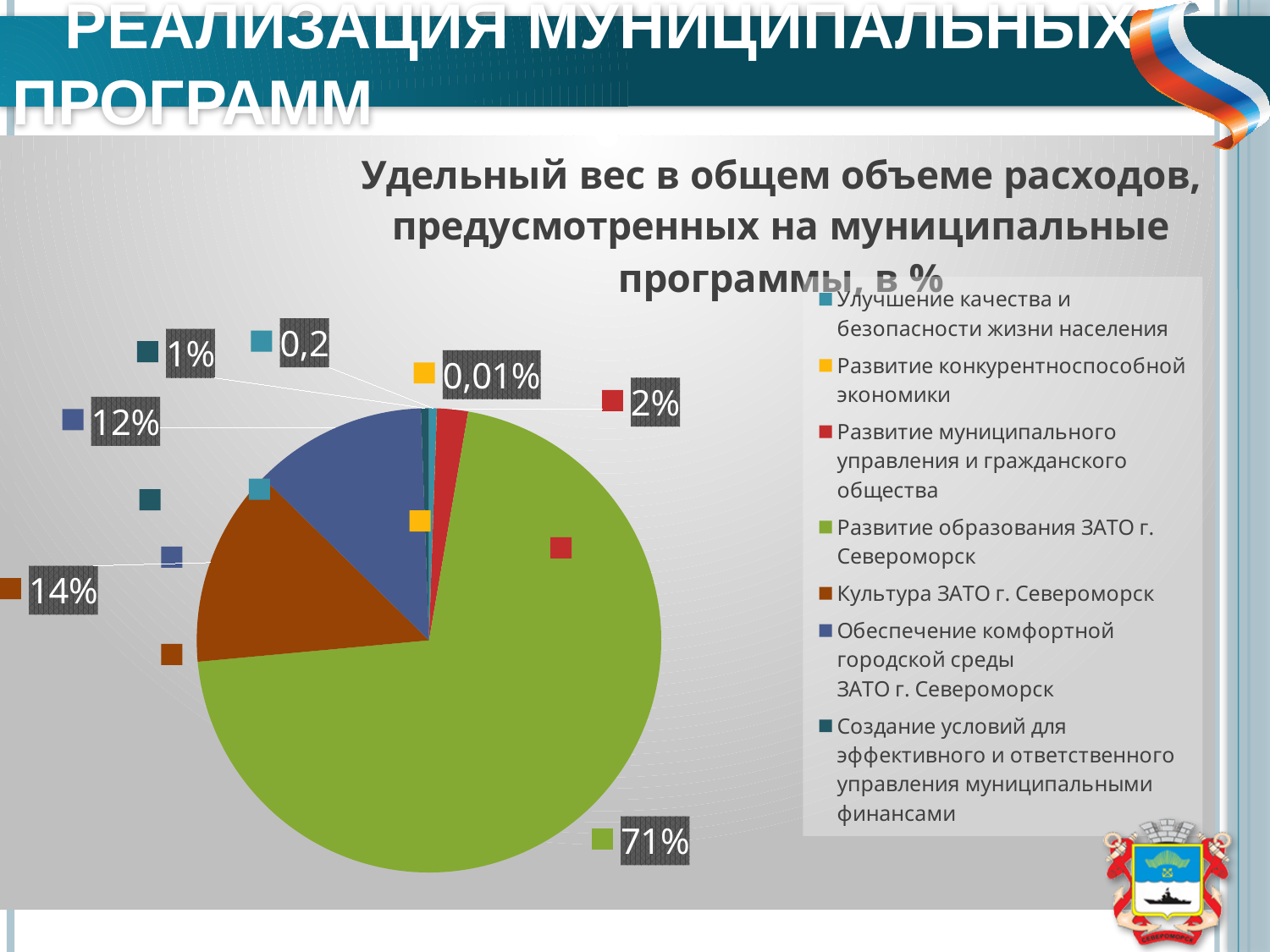
What value is shown for Развитие конкурентноспособной экономики? 0,01% What colour is the slice for Развитие образования ЗАТО г. Североморск? Green Which category has the largest slice of the pie? Развитие образования ЗАТО г. Североморск What is the difference between the shares of Культура ЗАТО г. Североморск and Обеспечение комфортной городской среды ЗАТО г. Североморск? 2% Which is larger: the share for Культура ЗАТО г. Североморск or for Развитие муниципального управления и гражданского общества? Культура ЗАТО г. Североморск What type of chart is shown on the slide? Pie chart Which category has the smallest slice of the pie? Развитие конкурентноспособной экономики What value is shown for Развитие муниципального управления и гражданского общества? 2% How many categories does the legend list? 7 What share of the pie does Развитие образования ЗАТО г. Североморск have? 71% What value is shown for Обеспечение комфортной городской среды ЗАТО г. Североморск? 12% What value is shown for Культура ЗАТО г. Североморск? 14%